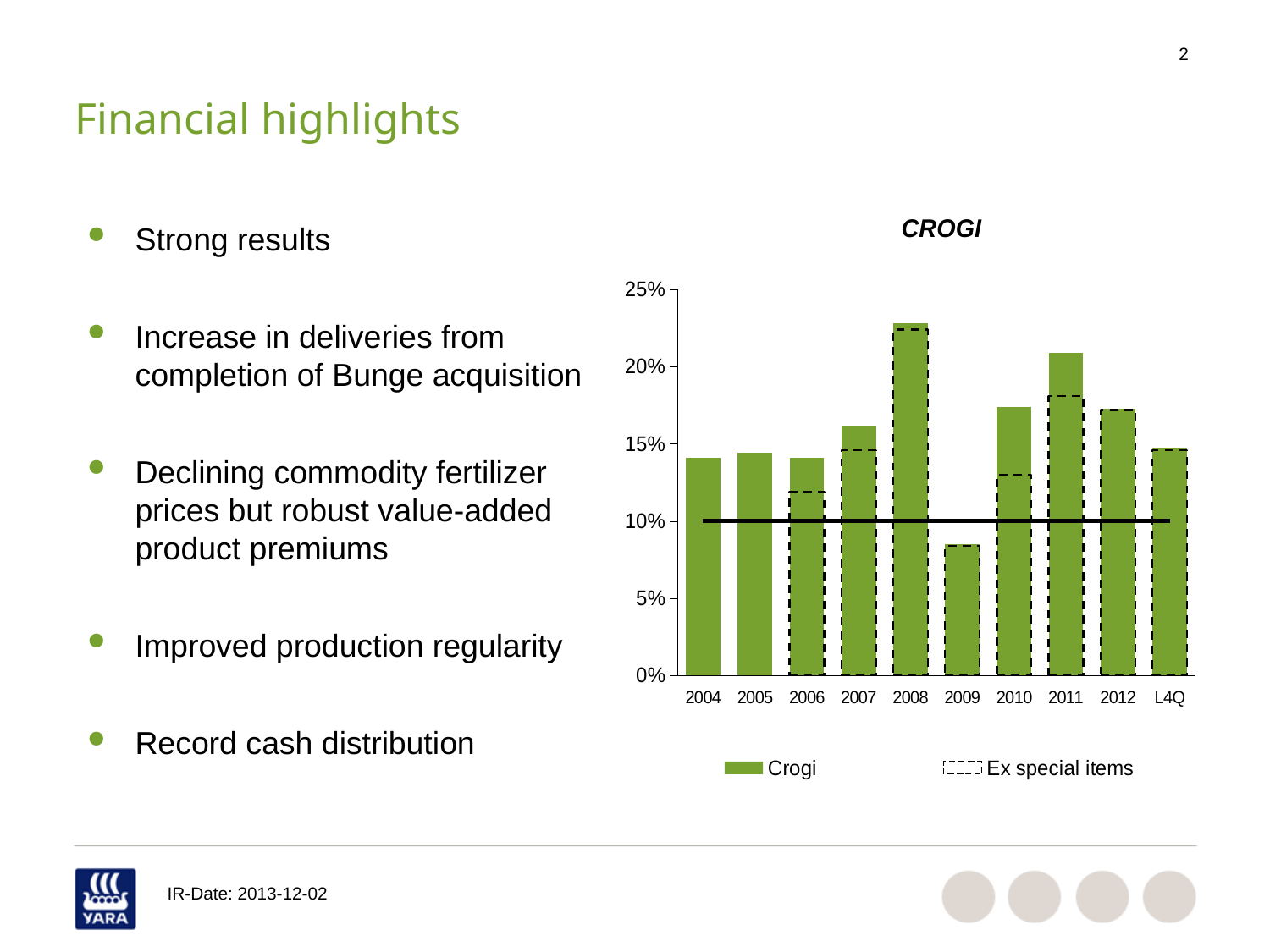
How many series does the legend list? 2 Which category has the highest Crogi bar? 2008 How many categories are shown on the x axis of the chart? 10 Which has the larger Crogi bar, 2004 or 2010? 2010 Is the Crogi value for 2008 greater or less than 20%? greater Is the Crogi value for 2007 greater or less than 15%? greater Which has the larger Crogi bar, 2011 or 2012? 2011 What kind of chart is shown on the slide? bar chart What is the title of the chart? CROGI What are the two entries listed in the chart legend? Crogi and Ex special items Is the Crogi value for 2009 greater or less than 10%? less Which category has the lowest Crogi bar? 2009